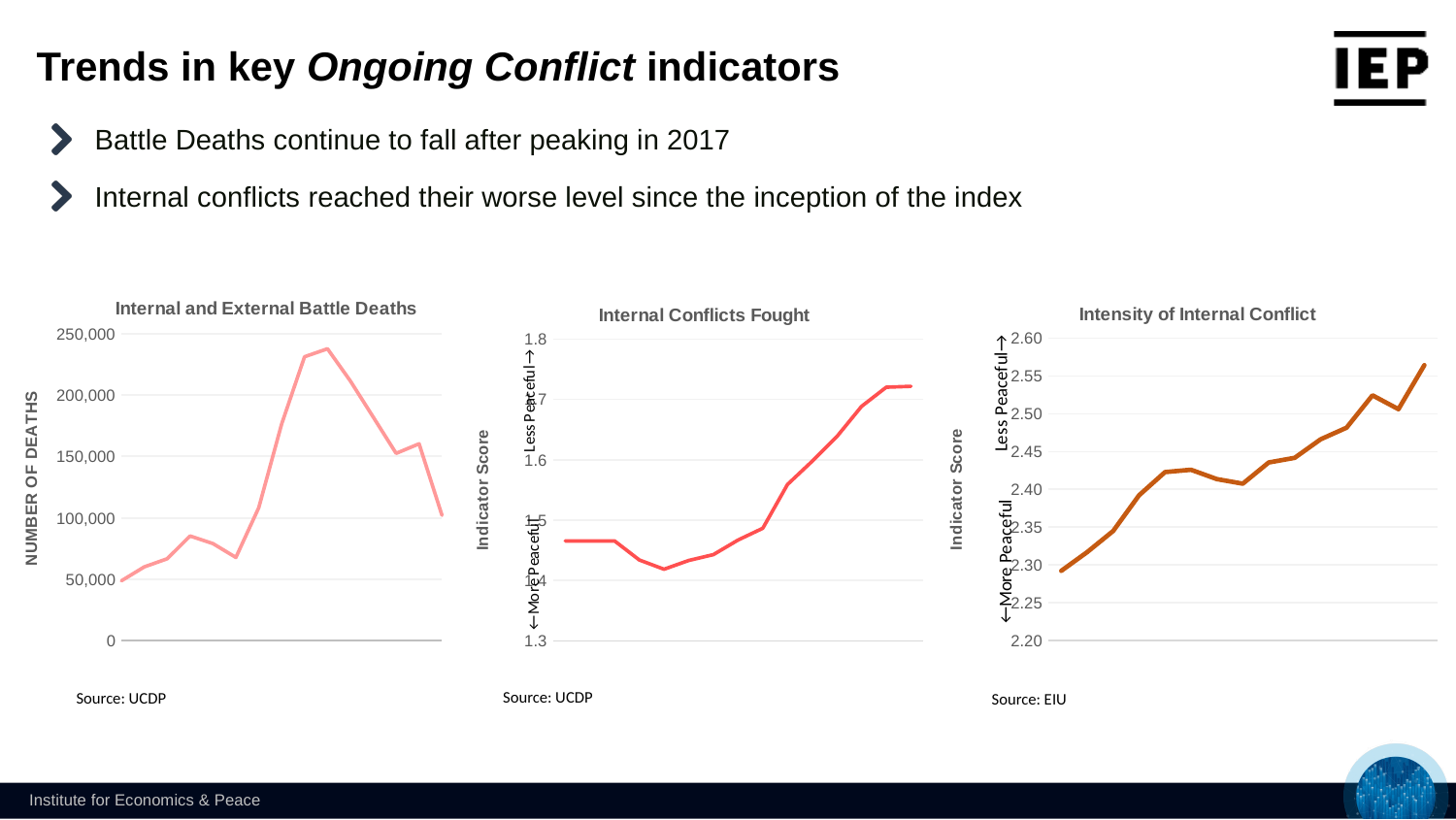
What source is cited below the 'Intensity of Internal Conflict' chart? EIU In the 'Internal Conflicts Fought' chart, is the lowest point of the line greater or less than 1.5? less How many charts are shown on the slide? 3 In the 'Intensity of Internal Conflict' chart, is the first value on the left greater or less than 2.35? less In the 'Internal and External Battle Deaths' chart, is the first value on the left greater or less than 100,000? less What is the y-axis label of the 'Internal and External Battle Deaths' chart? NUMBER OF DEATHS In the 'Intensity of Internal Conflict' chart, do the values overall rise or fall from left to right? rise What type of chart is the 'Internal and External Battle Deaths' chart? line chart